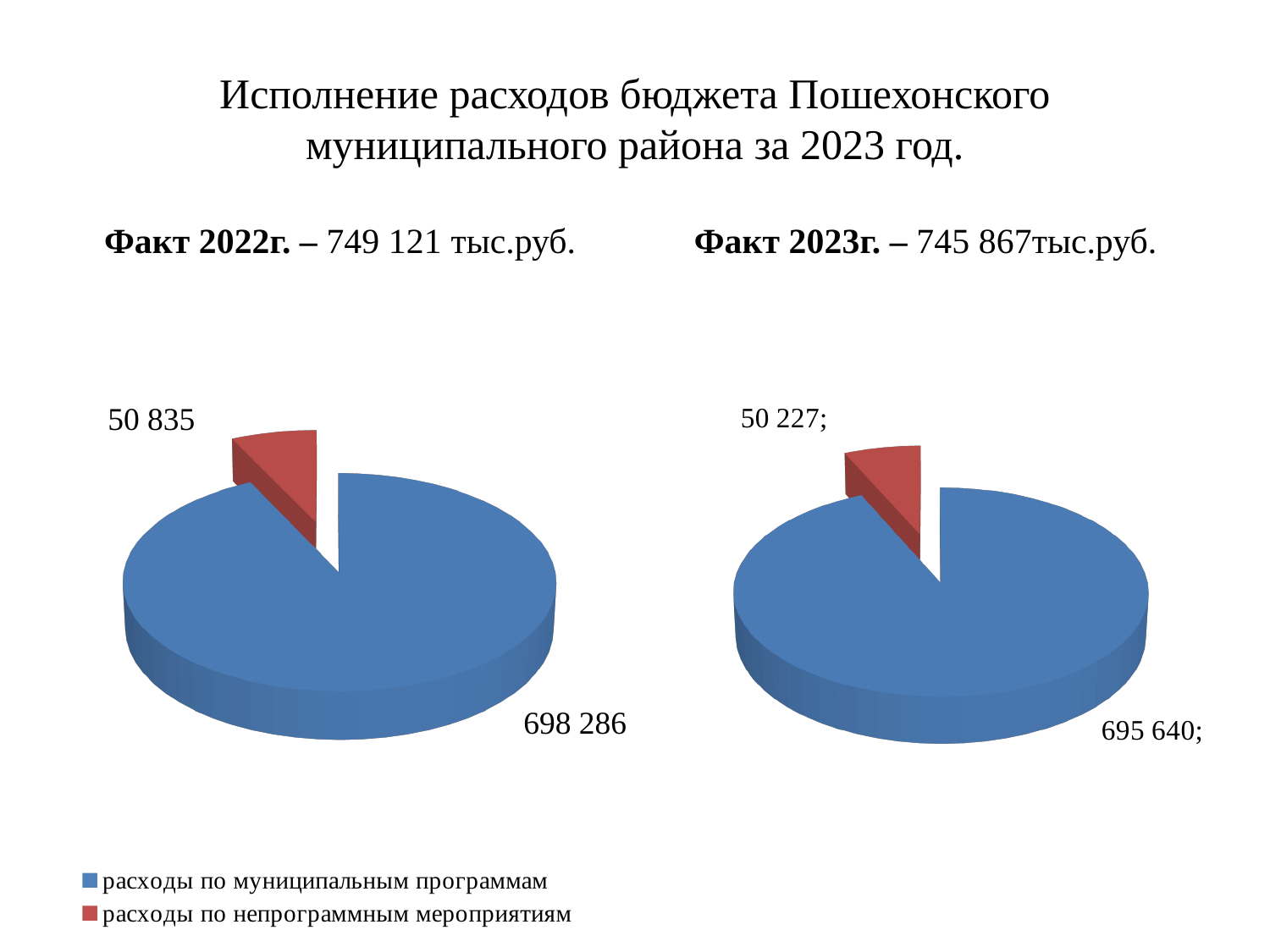
How many slices does each pie chart on the slide have? 2 What type of chart is used on this slide? Pie chart In the left pie chart (Факт 2022г.), what is the value for расходы по непрограммным мероприятиям? 50 835 What colour represents расходы по непрограммным мероприятиям in the legend? Red In the right pie chart (Факт 2023г.), what is the value for расходы по муниципальным программам? 695 640 In the right pie chart (Факт 2023г.), what is the value for расходы по непрограммным мероприятиям? 50 227 In the left pie chart (Факт 2022г.), which category has the largest slice? расходы по муниципальным программам In the left pie chart (Факт 2022г.), what is the value for расходы по муниципальным программам? 698 286 Which is larger: расходы по муниципальным программам in the left chart (2022) or in the right chart (2023)? Left chart (2022), 698 286 What is the difference between the value for расходы по непрограммным мероприятиям in the left chart (2022) and in the right chart (2023)? 608 In the left pie chart (Факт 2022г.), what is the difference between расходы по муниципальным программам and расходы по непрограммным мероприятиям? 647 451 In the right pie chart (Факт 2023г.), which category has the smallest slice? расходы по непрограммным мероприятиям